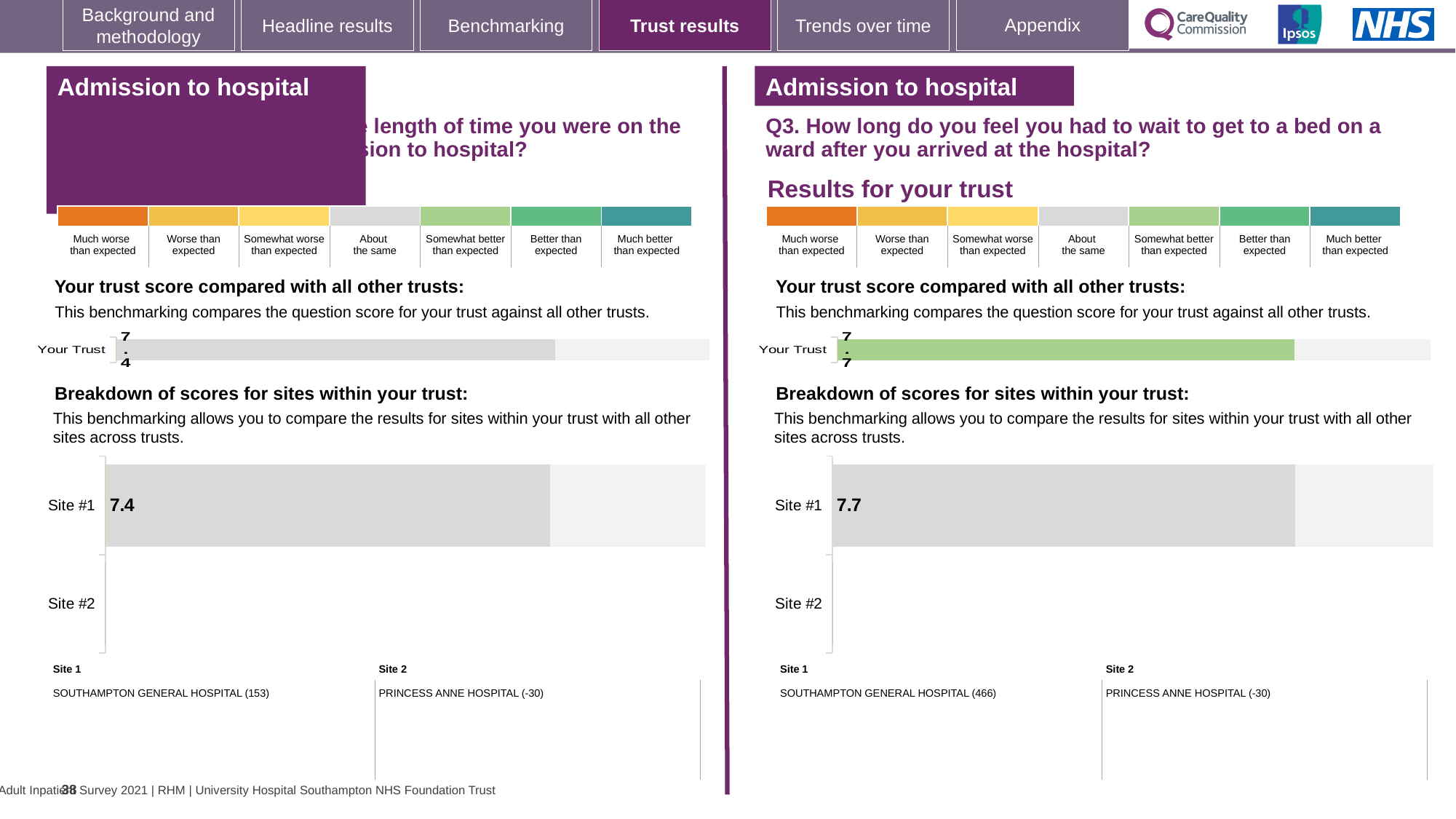
How many sites are listed on the right-hand 'Breakdown of scores for sites within your trust' chart for Q3? 2 What is the difference between the Site #1 score on the right-hand Q3 breakdown chart and the Site #1 score on the left-hand breakdown chart? 0.3 Which is larger: the Your Trust score on the left-hand chart or the Your Trust score on the right-hand Q3 chart? The right-hand Q3 chart On the right-hand Q3 'Your trust score compared with all other trusts' chart, what colour is the Your Trust bar? Green On the right-hand 'Breakdown of scores for sites within your trust' chart for Q3, what is the score for Site #1? 7.7 On the left-hand 'Your trust score compared with all other trusts' chart, what is the score shown for Your Trust? 7.4 What kind of chart is the 'Your Trust' chart on the left-hand side of the slide? Bar chart On the left-hand 'Breakdown of scores for sites within your trust' chart, what is the score for Site #1? 7.4 On the right-hand 'Your trust score compared with all other trusts' chart for Q3, what is the score shown for Your Trust? 7.7 On the left-hand 'Your trust score compared with all other trusts' chart, what colour is the Your Trust bar? Grey On the right-hand Q3 breakdown chart, which site has a bar plotted: Site #1 or Site #2? Site #1